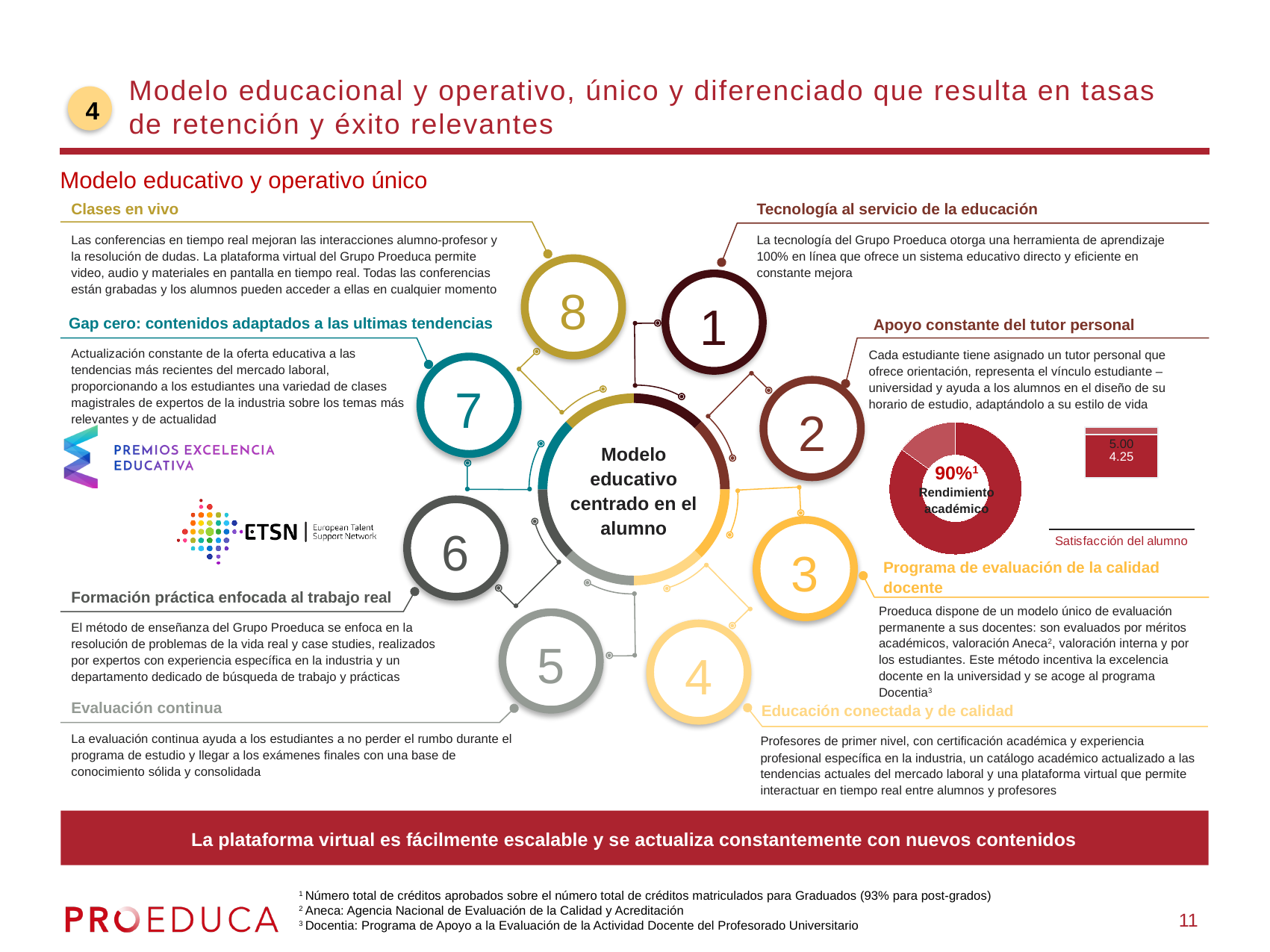
What is the maximum scale value shown on the "Satisfacción del alumno" chart? 5.00 How many bars are plotted in the "Satisfacción del alumno" chart? 1 Is the value in the "Satisfacción del alumno" chart greater or less than 5.00? less What kind of chart is used to display "Rendimiento académico"? Donut (pie) chart What kind of chart is used for "Satisfacción del alumno"? Bar chart What is the title of the donut chart next to the "Apoyo constante del tutor personal" section? Rendimiento académico What value is printed on the bar in the "Satisfacción del alumno" chart? 4.25 What percentage is shown in the centre of the donut chart labelled "Rendimiento académico"? 90%